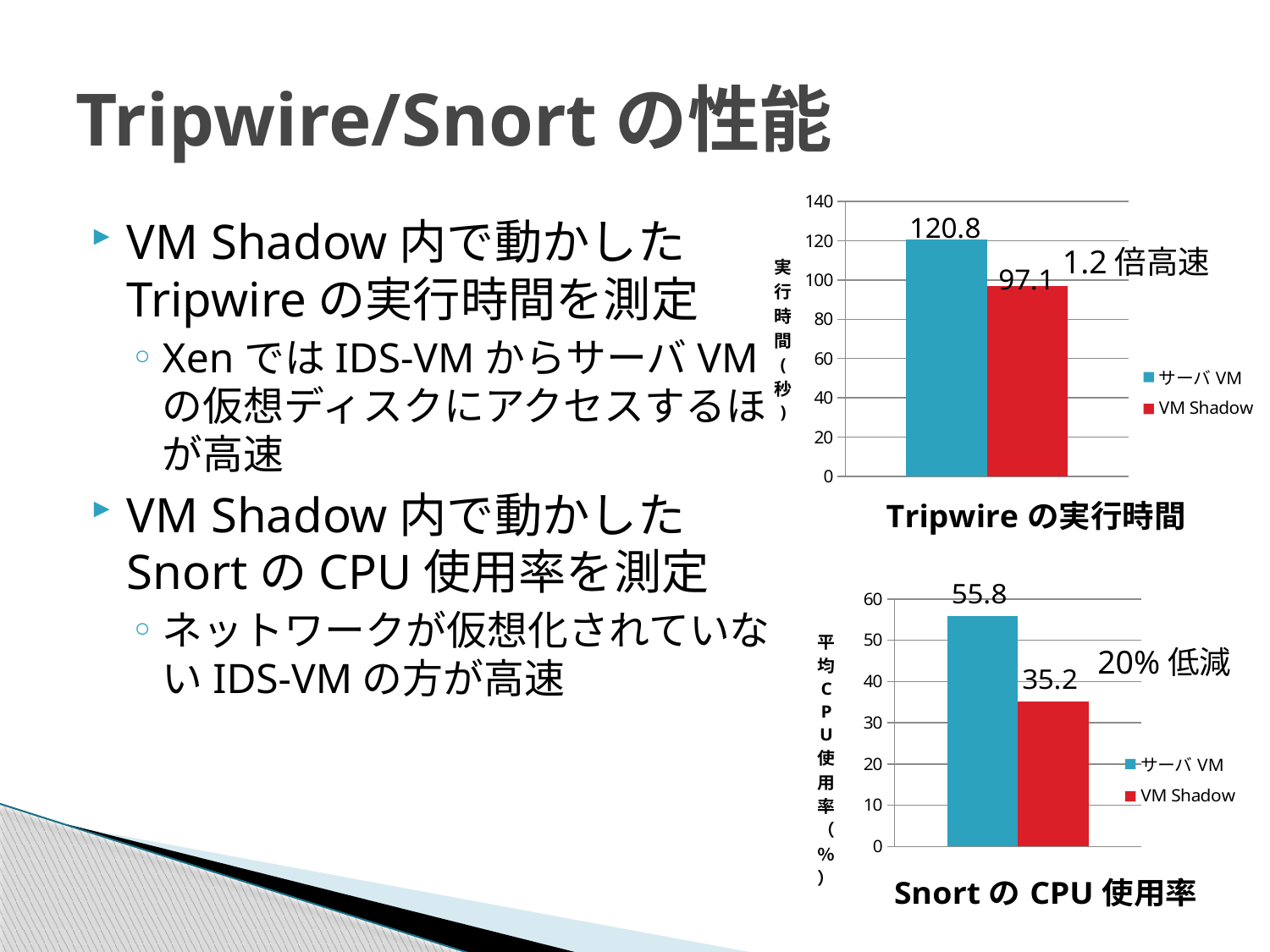
In the 'Snort の CPU 使用率' chart, what is the value for VM Shadow? 35.2 In the 'Snort の CPU 使用率' chart, what is the difference between the サーバ VM and VM Shadow values? 20.6 In the 'Tripwire の実行時間' chart, what is the value for サーバ VM? 120.8 In the 'Tripwire の実行時間' chart, which series has the higher value? サーバ VM In the 'Tripwire の実行時間' chart, is the value for VM Shadow greater or less than 100? less What kind of chart is the 'Snort の CPU 使用率' chart? bar chart In the 'Snort の CPU 使用率' chart, which series has the lower value? VM Shadow In the 'Tripwire の実行時間' chart, what is the value for VM Shadow? 97.1 In the 'Tripwire の実行時間' chart, what is the difference between the サーバ VM and VM Shadow values? 23.7 In the 'Snort の CPU 使用率' chart, what is the value for サーバ VM? 55.8 In the 'Tripwire の実行時間' chart, how many series does the legend list? 2 In the 'Snort の CPU 使用率' chart, what colour is the VM Shadow bar? red